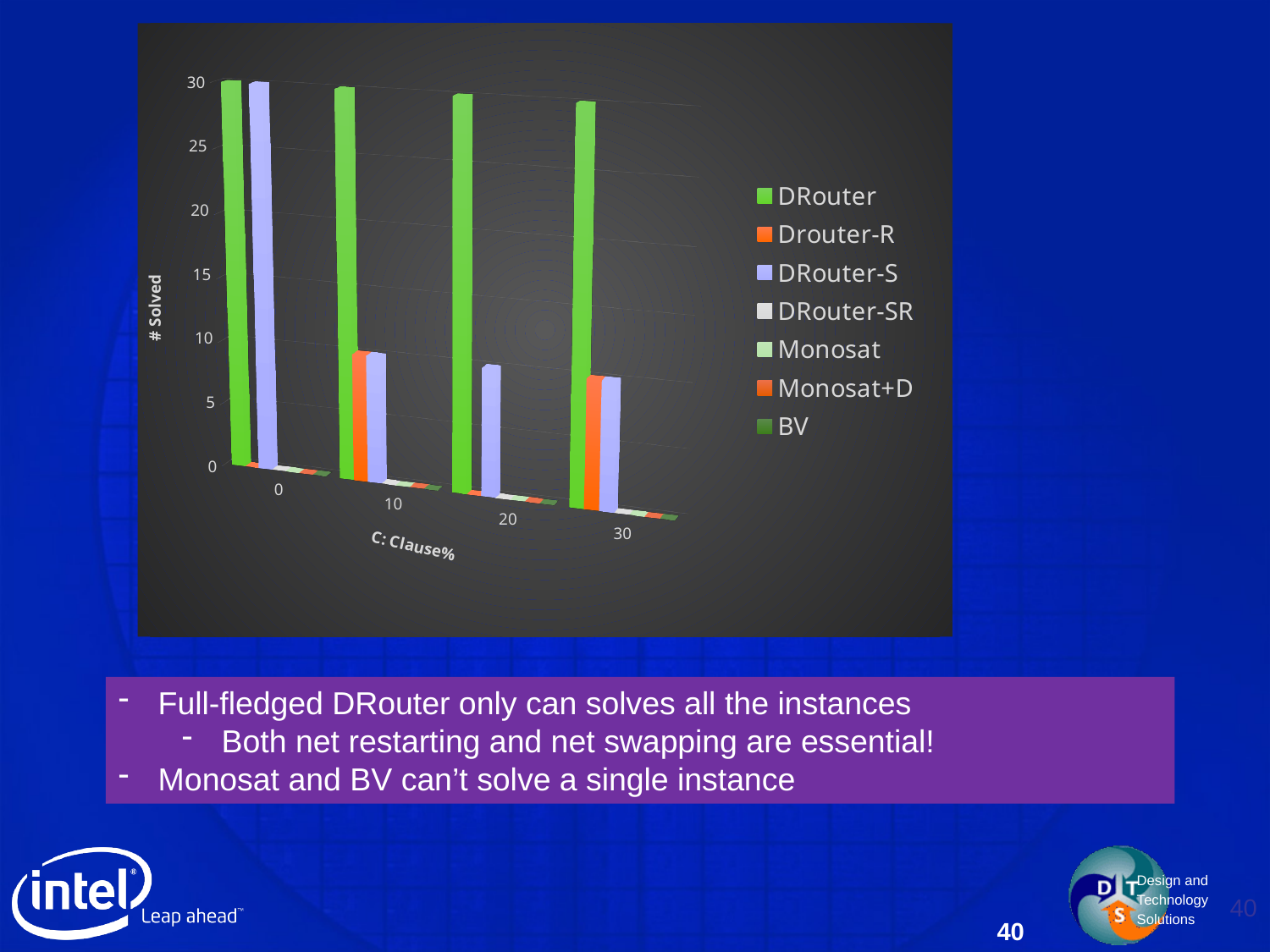
Is the value for DRouter-S at C: Clause% = 20 greater or less than 15? less Does the value for DRouter-S rise or fall from C: Clause% = 0 to C: Clause% = 10? fall Is the value for DRouter-S at C: Clause% = 0 greater or less than 25? greater How many series does the legend list? 7 What kind of chart is shown on the slide? bar chart Is the value for DRouter at C: Clause% = 0 greater or less than 25? greater How many categories are shown along the C: Clause% axis? 4 What is the title of the vertical axis? # Solved At C: Clause% = 0, which is larger: the value for DRouter or the value for Drouter-R? DRouter Which series has the highest value at C: Clause% = 10? DRouter What is the title of the horizontal axis? C: Clause%